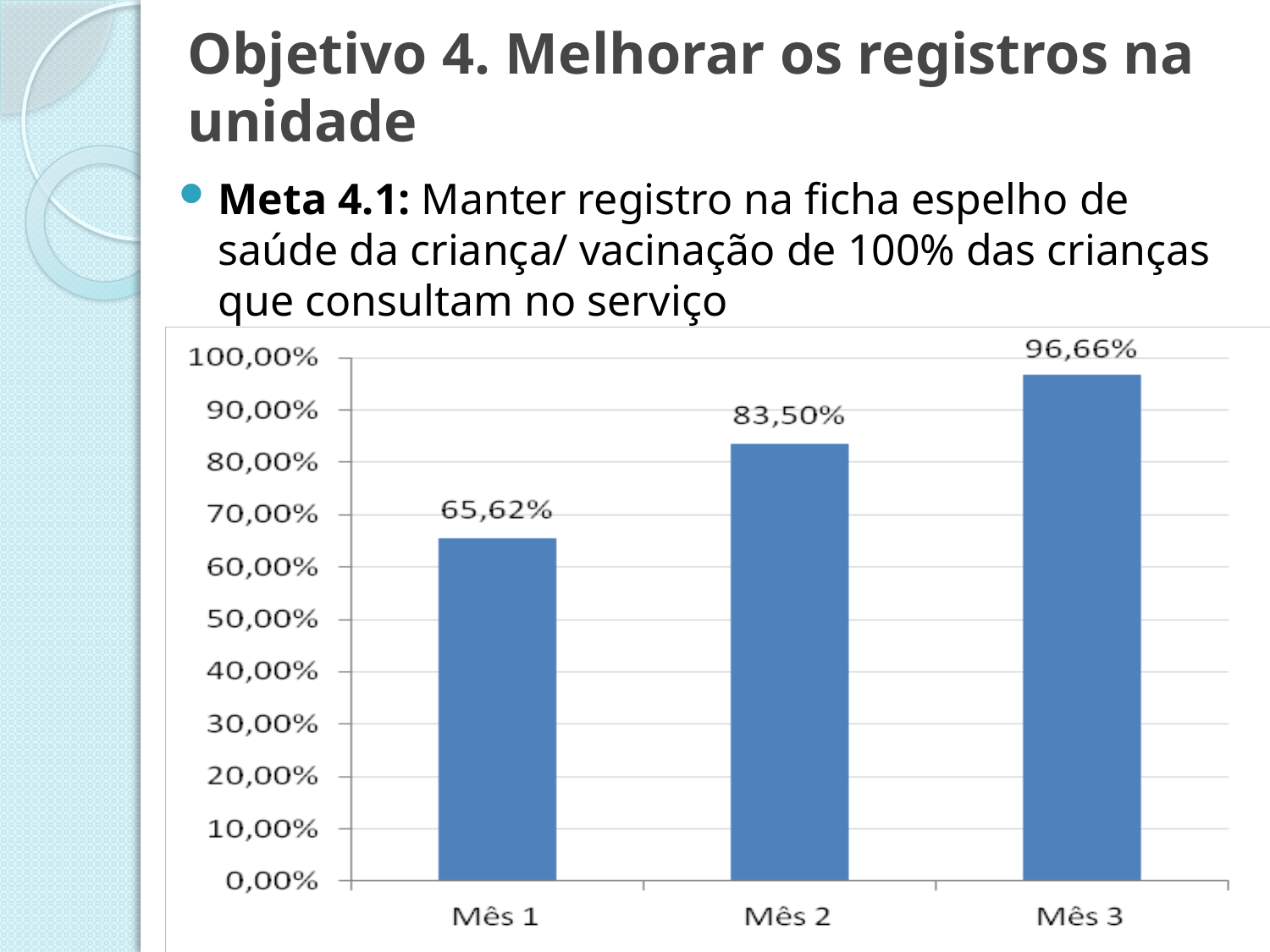
What is the value for Mês 3? 96,66% What is the value for Mês 1? 65,62% Which month has the lowest value? Mês 1 What is the value for Mês 2? 83,50% What is the difference between the values for Mês 2 and Mês 1? 17,88% How many categories are shown on the x axis? 3 Do the values rise or fall from Mês 1 to Mês 3? rise What kind of chart is shown on the slide? bar chart Which month has the highest value? Mês 3 Which is larger, the value for Mês 1 or the value for Mês 2? Mês 2 What is the difference between the values for Mês 3 and Mês 1? 31,04% Is the value for Mês 2 greater or less than 80,00%? greater